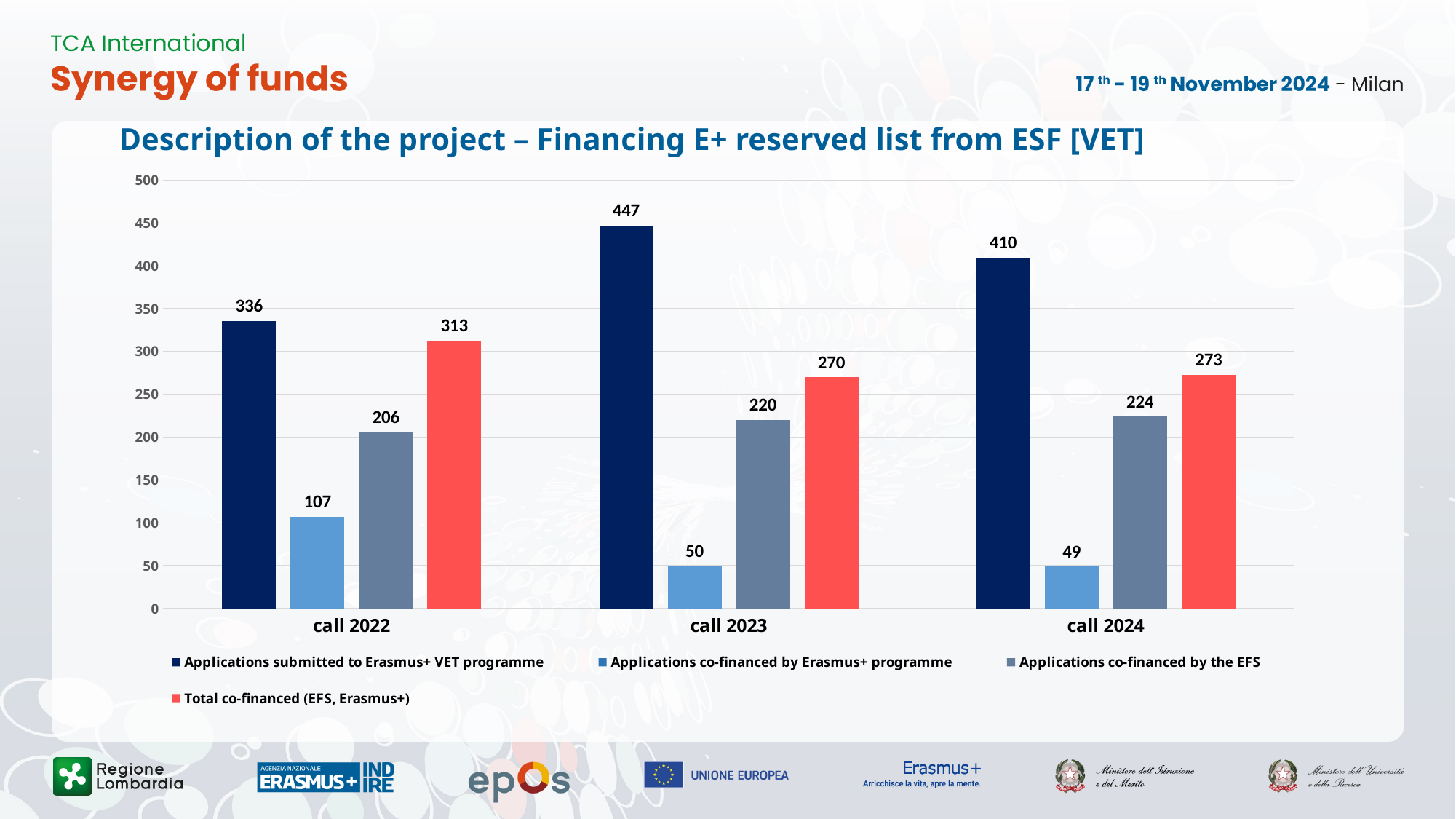
What is the Total co-financed (EFS, Erasmus+) value for call 2022? 313 Do the values for Applications co-financed by the Erasmus+ programme rise or fall from call 2022 to call 2024? fall Which is larger: the Total co-financed value for call 2023 or for call 2024? call 2024 What is the value for Applications co-financed by the EFS in call 2024? 224 How many applications were submitted to the Erasmus+ VET programme in call 2023? 447 What kind of chart is shown on the slide? bar chart What is the difference between applications submitted to the Erasmus+ VET programme in call 2023 and call 2024? 37 How many calls are shown on the x axis of the chart? 3 How many series does the legend list? 4 In which call was the number of applications co-financed by the Erasmus+ programme lowest? call 2024 In which call were the most applications submitted to the Erasmus+ VET programme? call 2023 Is the value for Applications co-financed by the EFS in call 2022 greater or less than 250? less